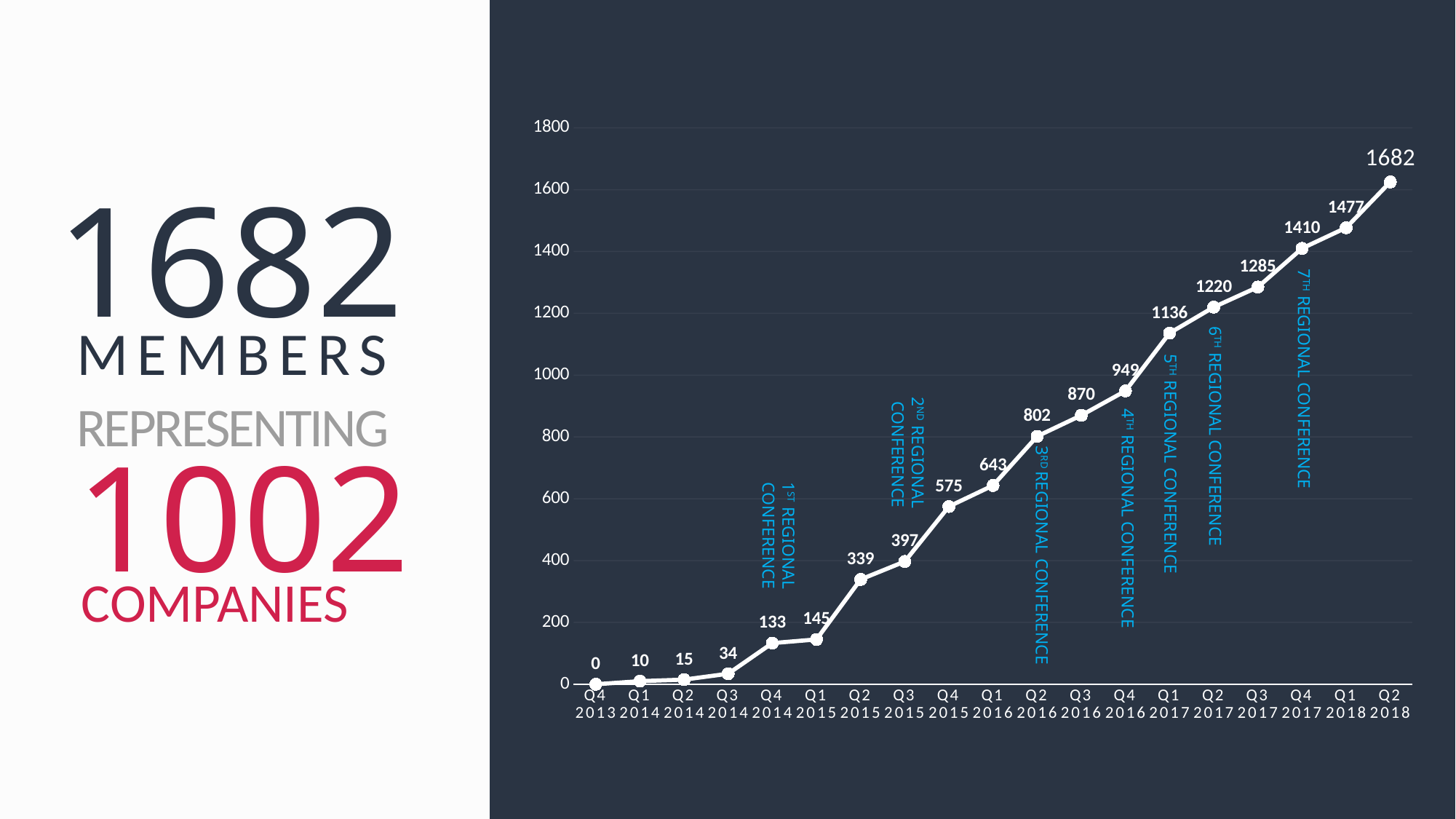
Which quarter has the lowest value? Q4 2013 Which quarter has the highest value? Q2 2018 What is the value for Q4 2015? 575 What is the difference between the values for Q2 2015 and Q1 2015? 194 Which is larger, the value for Q3 2016 or the value for Q4 2016? Q4 2016 What is the difference between the values for Q2 2018 and Q1 2018? 205 What is the value for Q1 2017? 1136 How many data points are plotted on the line? 19 What is the value for Q2 2018? 1682 Which regional conference annotation is placed nearest the Q4 2017 point? 7th Regional Conference Do the values rise or fall from Q4 2013 to Q2 2018? Rise What type of chart is shown on the slide? Line chart